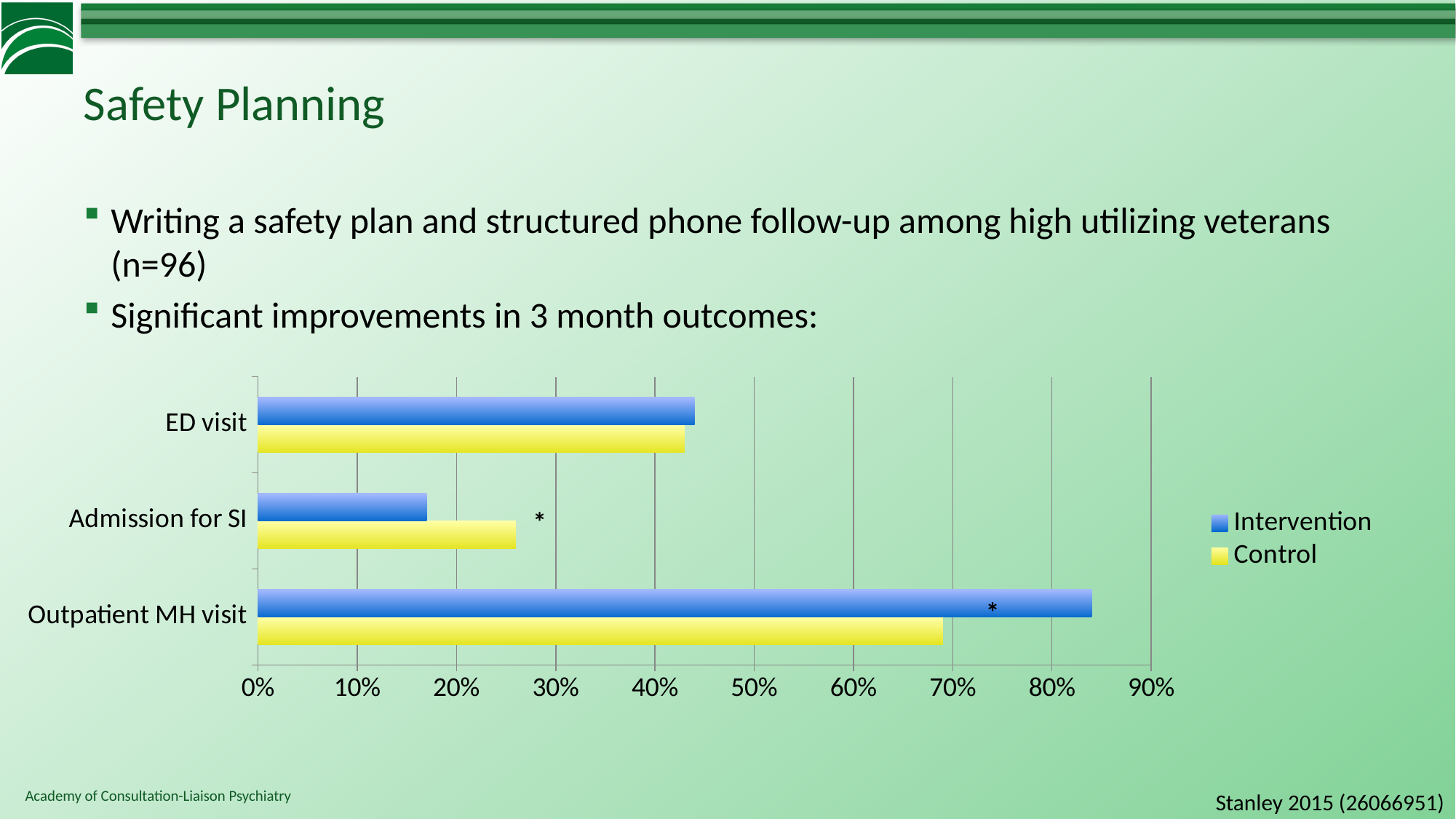
For Outpatient MH visit, which is larger, the Intervention value or the Control value? Intervention Is the Intervention value for Outpatient MH visit greater or less than 80%? greater Which category has the lowest Intervention value? Admission for SI Which category has the lowest Control value? Admission for SI Is the Control value for ED visit greater or less than 50%? less How many outcome categories are shown on the chart? 3 For Admission for SI, which is larger, the Intervention value or the Control value? Control What kind of chart is shown on the slide? bar chart How many series does the chart legend list? 2 Which category has the highest Intervention value? Outpatient MH visit Which series is shown in yellow in the chart legend? Control Is the Intervention value for Admission for SI greater or less than 20%? less